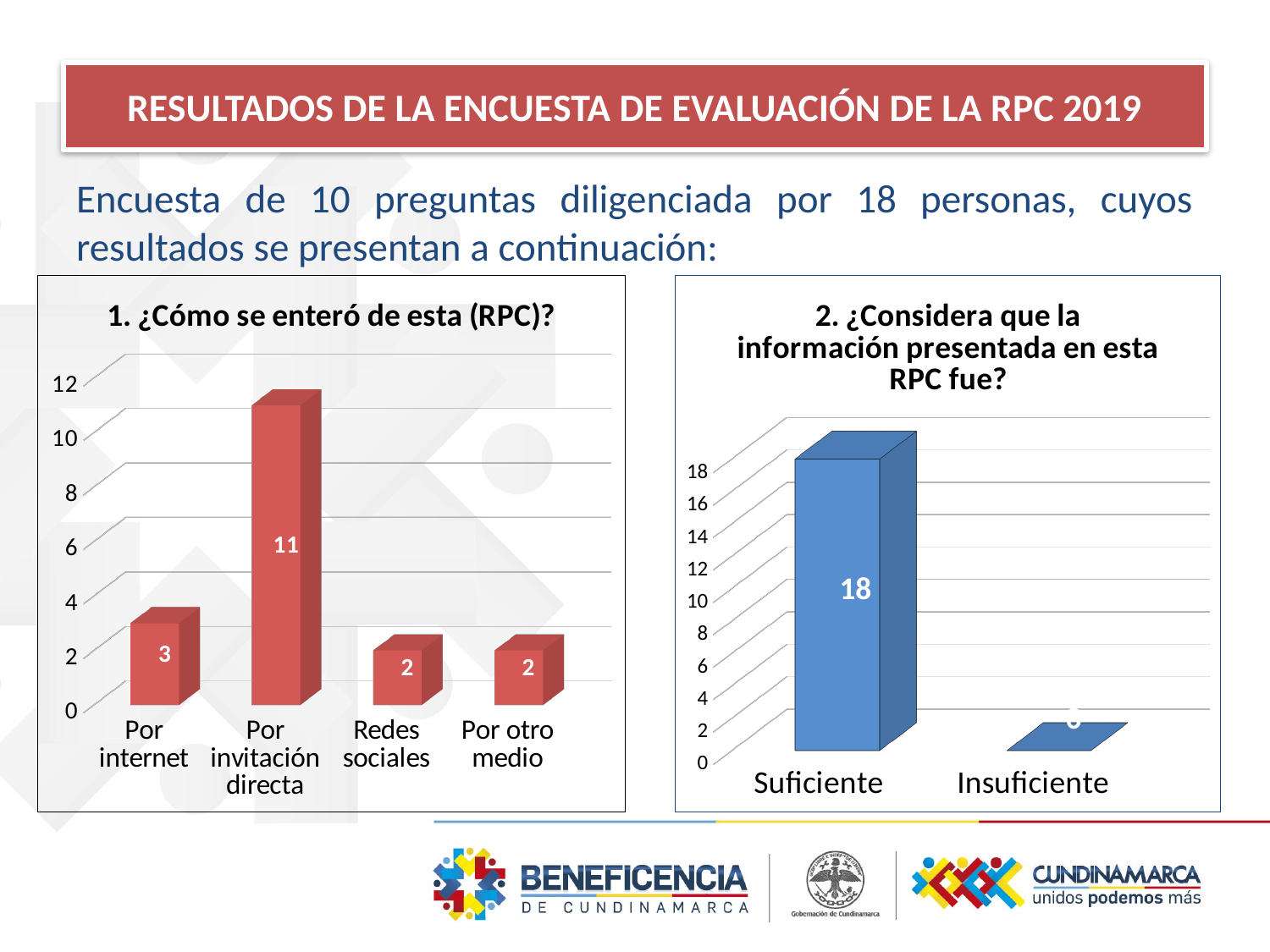
In the chart titled "1. ¿Cómo se enteró de esta (RPC)?", what is the value for "Redes sociales"? 2 In the chart titled "1. ¿Cómo se enteró de esta (RPC)?", what is the difference between the values for "Por invitación directa" and "Por internet"? 8 In the chart titled "1. ¿Cómo se enteró de esta (RPC)?", how many categories are shown on the x axis? 4 In the chart titled "1. ¿Cómo se enteró de esta (RPC)?", which category has the highest value? Por invitación directa In the chart titled "1. ¿Cómo se enteró de esta (RPC)?", is the value for "Por invitación directa" greater or less than 10? greater In the chart titled "2. ¿Considera que la información presentada en esta RPC fue?", which is larger, the value for "Suficiente" or for "Insuficiente"? Suficiente In the chart titled "1. ¿Cómo se enteró de esta (RPC)?", what is the value for "Por internet"? 3 In the chart titled "2. ¿Considera que la información presentada en esta RPC fue?", which category has the lowest value? Insuficiente What kind of chart is the left chart, titled "1. ¿Cómo se enteró de esta (RPC)?"? bar chart In the chart titled "1. ¿Cómo se enteró de esta (RPC)?", what is the value for "Por invitación directa"? 11 In the chart titled "2. ¿Considera que la información presentada en esta RPC fue?", how many categories are shown on the x axis? 2 In the chart titled "2. ¿Considera que la información presentada en esta RPC fue?", what is the value for "Suficiente"? 18